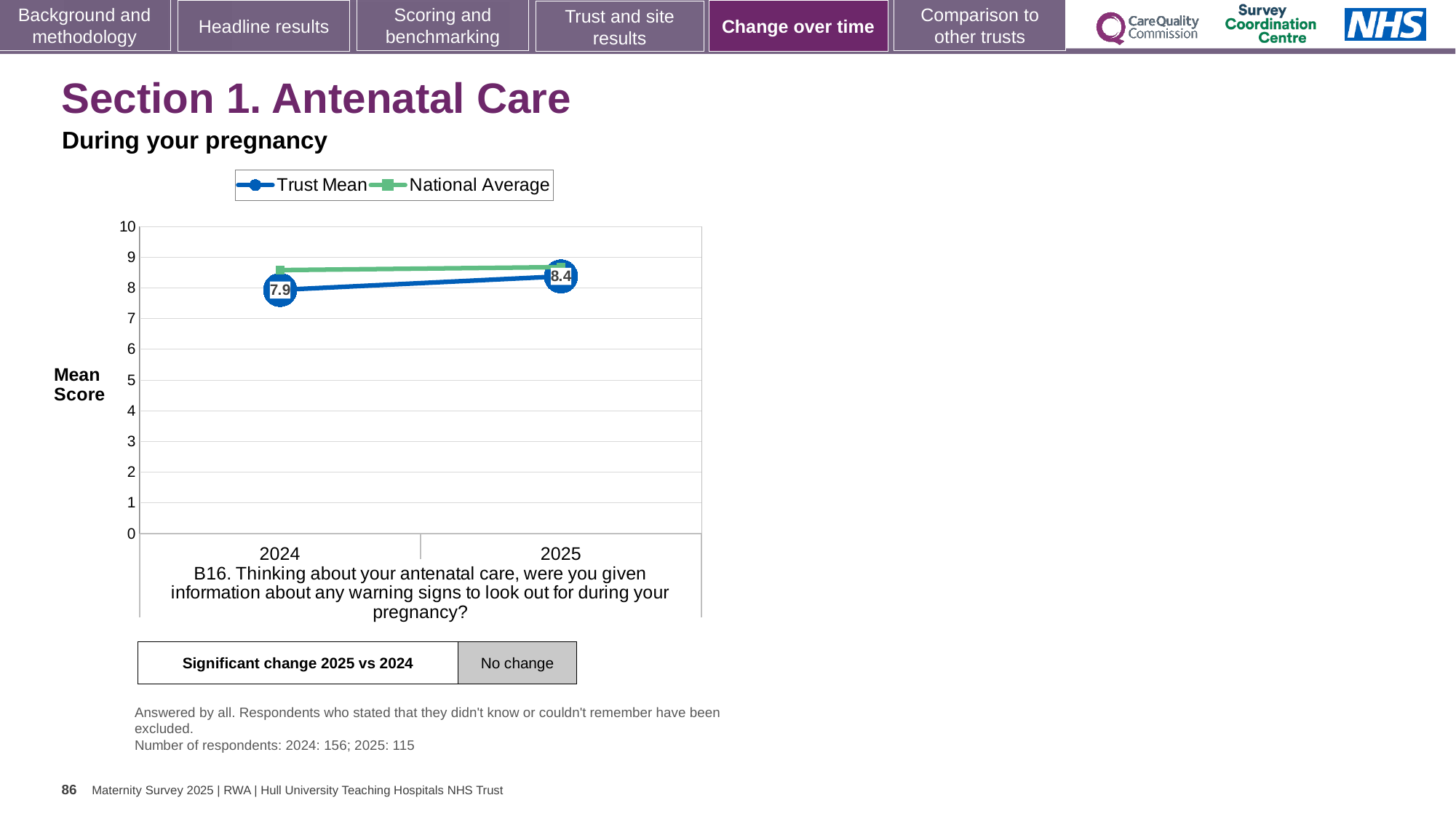
In 2024, which is higher, the Trust Mean or the National Average? National Average Is the National Average value for 2024 greater or less than 8? greater What is the Trust Mean value for 2024? 7.9 Is the National Average value for 2025 greater or less than 9? less What is the Trust Mean value for 2025? 8.4 What is the label on the y axis of the chart? Mean Score What is the difference between the Trust Mean in 2025 and in 2024? 0.5 What kind of chart is shown on the slide? line chart Does the Trust Mean rise or fall from 2024 to 2025? rise Which year has the higher Trust Mean, 2024 or 2025? 2025 How many series does the legend list? 2 How many years are plotted on the x axis? 2